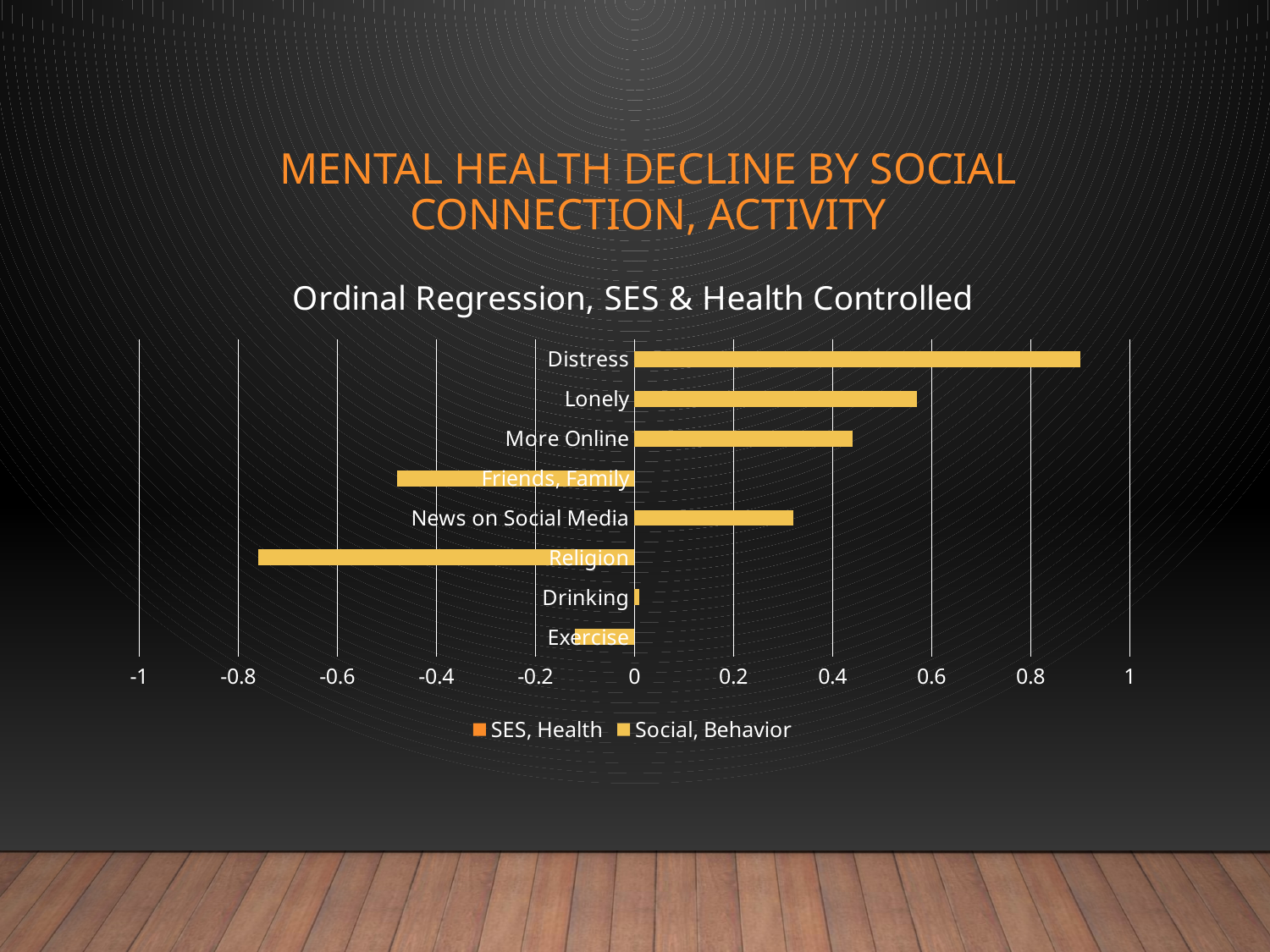
How many categories are plotted on the chart? 8 Which has the larger value, Lonely or More Online? Lonely Is the value for News on Social Media greater or less than 0.2? greater Is the value for Religion greater or less than -0.6? less Is the value for Friends, Family greater or less than -0.4? less How many series does the legend list? 2 What is the title of the chart? Ordinal Regression, SES & Health Controlled What kind of chart is shown on the slide? bar chart Which category has the highest value? Distress Which category has the lowest value? Religion